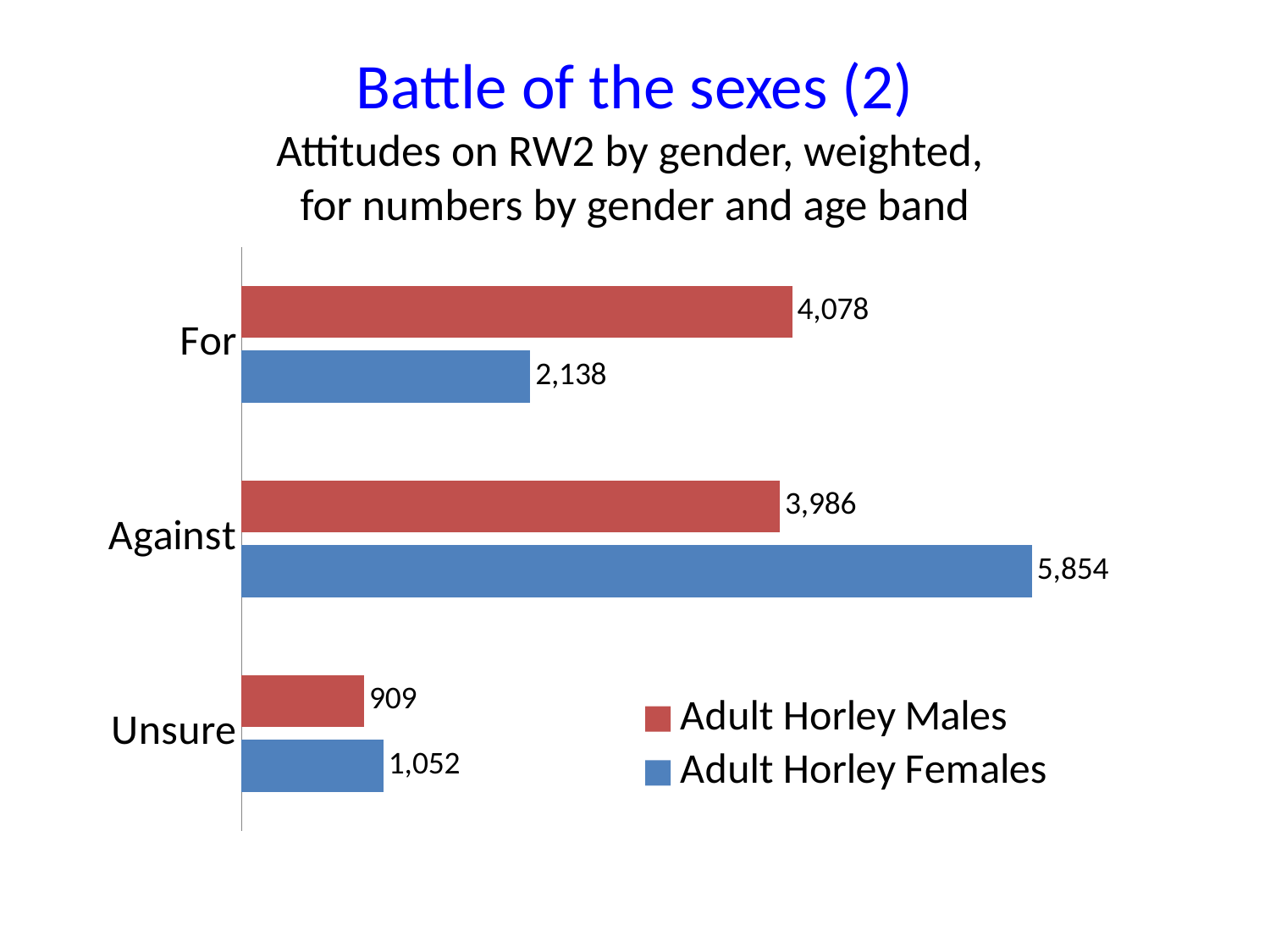
Which category has the highest value for Adult Horley Females? Against What kind of chart is shown on the slide? Bar chart What is the difference between Adult Horley Females and Adult Horley Males in the Against category? 1,868 Which category has the lowest value for Adult Horley Males? Unsure What is the difference between Adult Horley Males and Adult Horley Females in the For category? 1,940 In the Unsure category, which series has the larger value, Adult Horley Males or Adult Horley Females? Adult Horley Females What is the value for Adult Horley Males in the For category? 4,078 How many categories are shown on the chart? 3 What is the value for Adult Horley Males in the Against category? 3,986 What is the value for Adult Horley Females in the Against category? 5,854 What is the value for Adult Horley Females in the Unsure category? 1,052 How many series does the legend list? 2